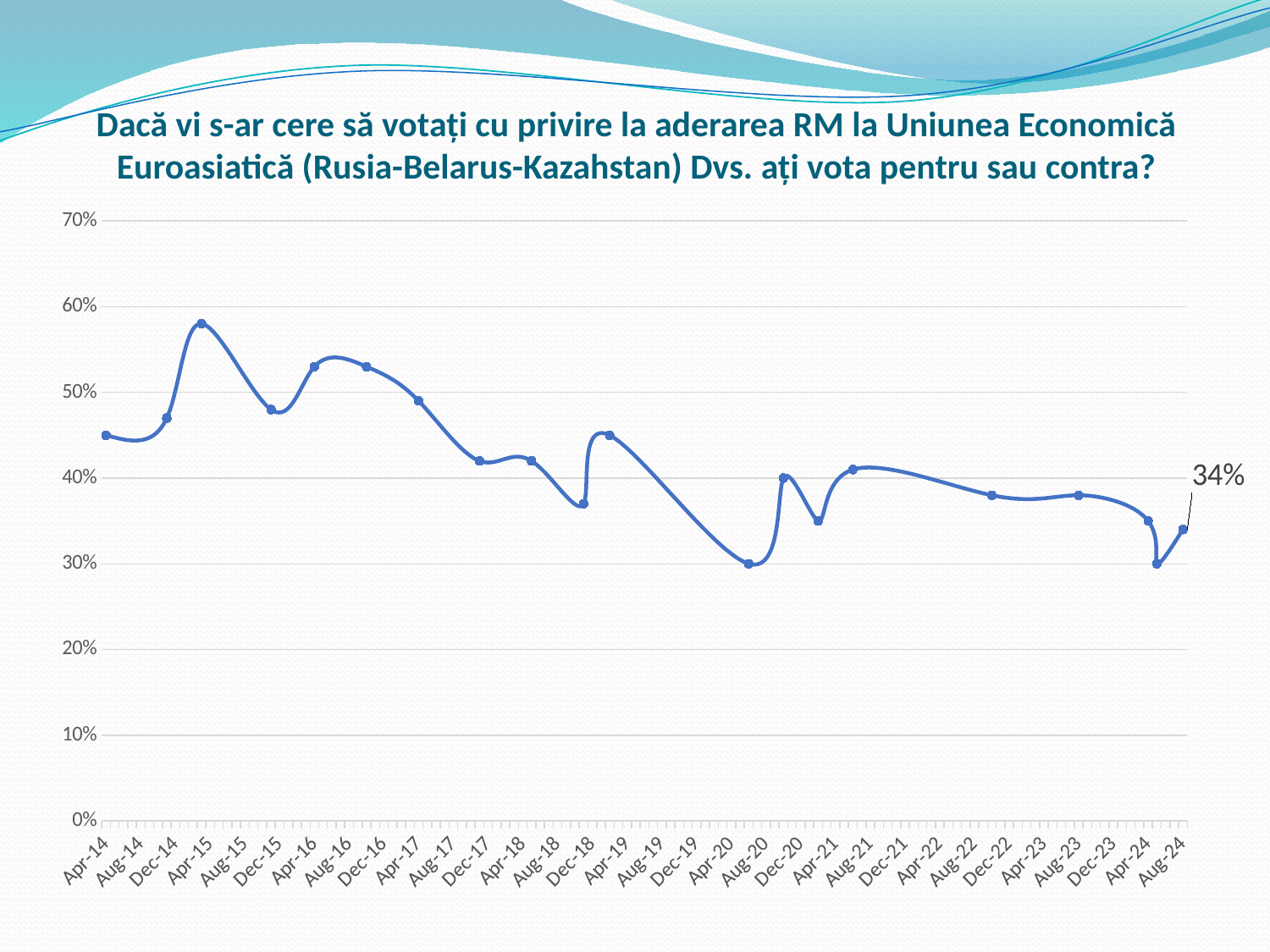
What value is labelled at the end of the line, for Aug-24? 34% Is the value for Apr-15 greater or less than 50%? greater Is the value for Dec-22 greater or less than 40%? less What kind of chart is shown on the slide? line chart Overall, do the values rise or fall from Apr-14 to Aug-24? fall Which is larger, the value for Apr-15 or the value for Aug-24? Apr-15 Is the value for Apr-14 greater or less than 40%? greater What is the highest percentage shown on the vertical axis? 70%